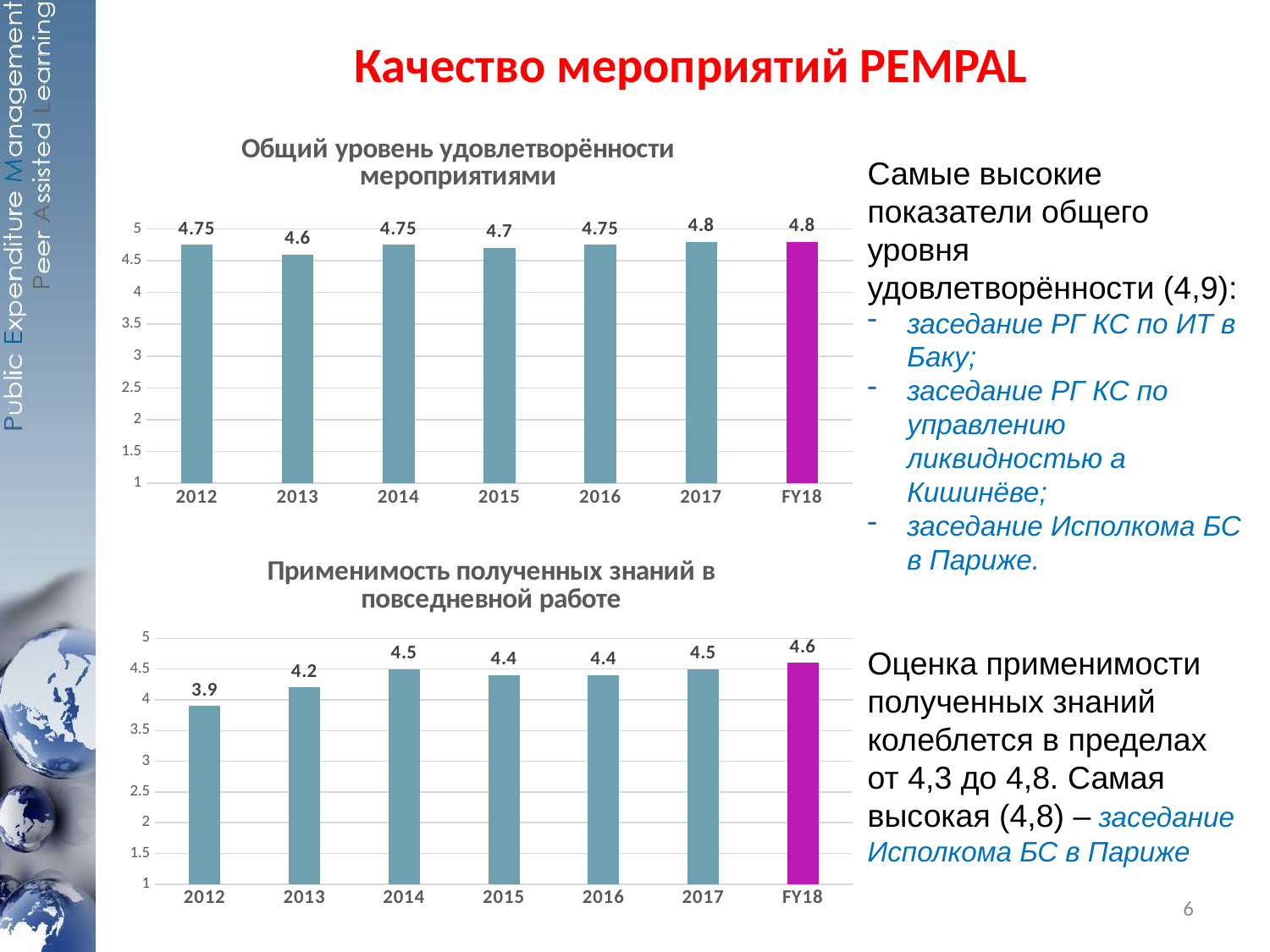
In the top chart (Общий уровень удовлетворённости мероприятиями), how many bars are plotted? 7 In the top chart (Общий уровень удовлетворённости мероприятиями), what is the value for FY18? 4.8 In the bottom chart (Применимость полученных знаний в повседневной работе), what is the value for 2012? 3.9 In the top chart (Общий уровень удовлетворённости мероприятиями), what is the value for 2013? 4.6 In the bottom chart (Применимость полученных знаний в повседневной работе), which is larger, the value for 2014 or the value for 2015? 2014 What type of chart is the bottom chart (Применимость полученных знаний в повседневной работе)? Bar chart In the top chart (Общий уровень удовлетворённости мероприятиями), what is the difference between the 2017 value and the 2013 value? 0.2 In the bottom chart (Применимость полученных знаний в повседневной работе), which year has the lowest value? 2012 In the bottom chart (Применимость полученных знаний в повседневной работе), which year has the highest value? FY18 In the bottom chart (Применимость полученных знаний в повседневной работе), what is the difference between the FY18 value and the 2012 value? 0.7 In the bottom chart (Применимость полученных знаний в повседневной работе), what colour is the FY18 bar? Magenta In the top chart (Общий уровень удовлетворённости мероприятиями), which year has the lowest value? 2013